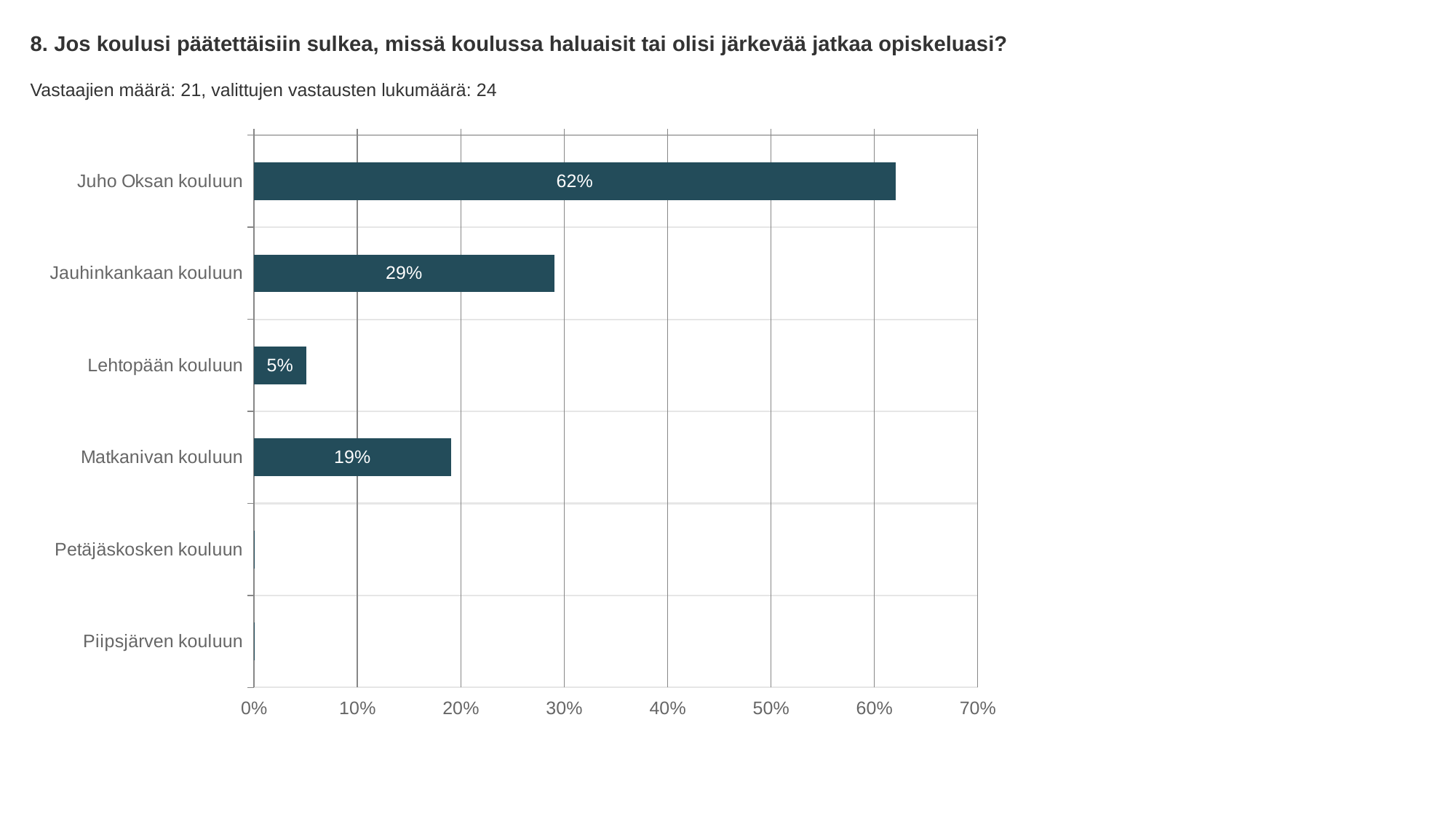
Which category has the highest value? Juho Oksan kouluun What is the value for Lehtopään kouluun? 5% Which is larger, the value for Matkanivan kouluun or Lehtopään kouluun? Matkanivan kouluun What is the difference between the values for Jauhinkankaan kouluun and Matkanivan kouluun? 10% What kind of chart is shown on the slide? Bar chart What is the value for Jauhinkankaan kouluun? 29% What is the difference between the values for Juho Oksan kouluun and Jauhinkankaan kouluun? 33% What is the value for Matkanivan kouluun? 19% Which category has the lowest value among those with a visible bar? Lehtopään kouluun How many respondents (Vastaajien määrä) are stated on the slide? 21 What is the value for Juho Oksan kouluun? 62% How many categories are listed on the chart? 6